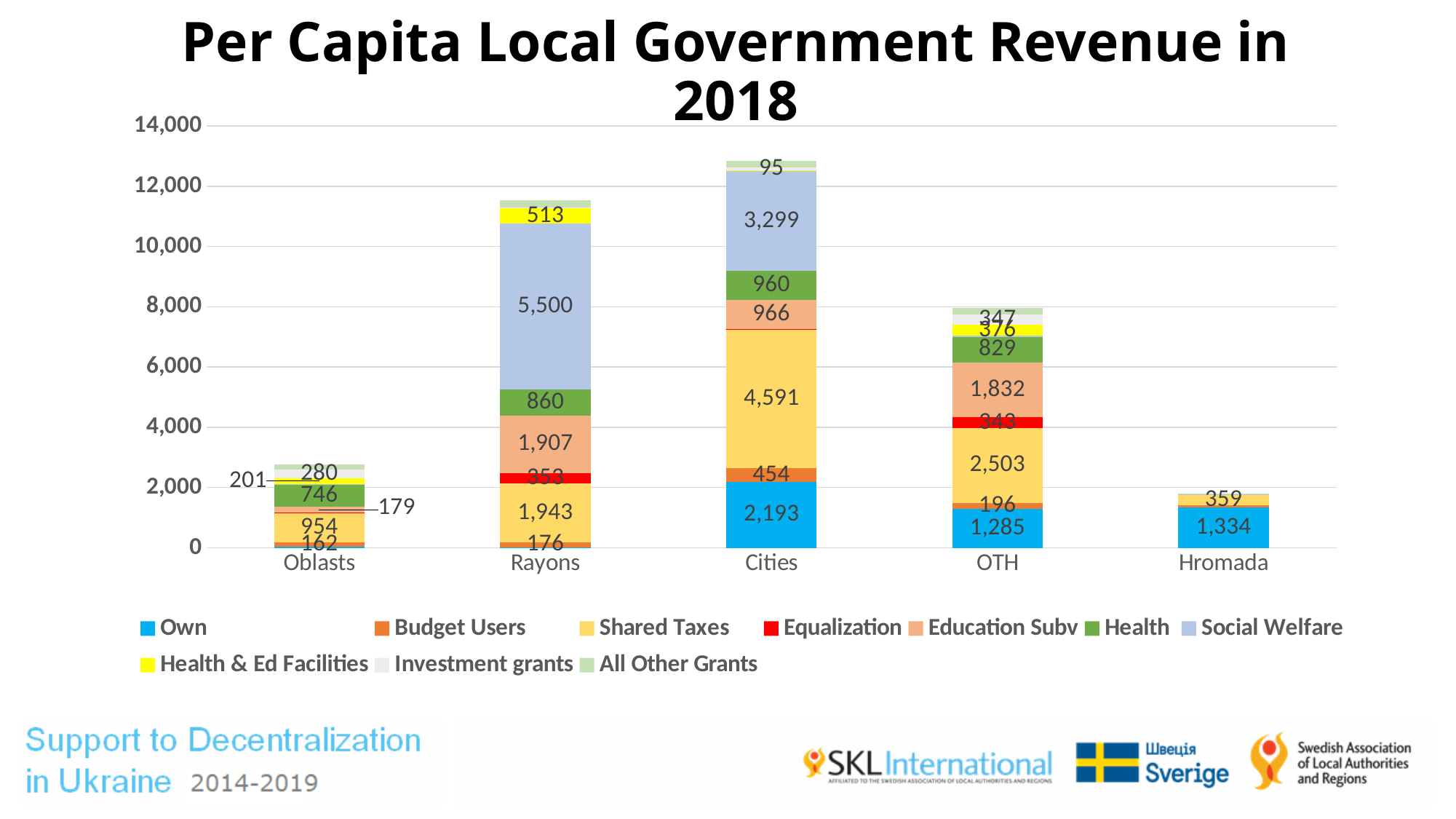
Which has the larger Education Subv value, Rayons or OTH? Rayons What is the Shared Taxes value for Cities? 4,591 What is the Social Welfare value for Rayons? 5,500 What is the title of the chart? Per Capita Local Government Revenue in 2018 Which category has the shortest stacked bar? Hromada How many series does the legend list? 10 What is the difference between the Own value for Cities and the Own value for OTH? 908 How many categories are shown on the x axis? 5 Which category has the tallest stacked bar? Cities What is the Own revenue value for Hromada? 1,334 Is the total height of the Rayons bar greater or less than 10,000? greater What kind of chart is shown on the slide? Stacked bar chart